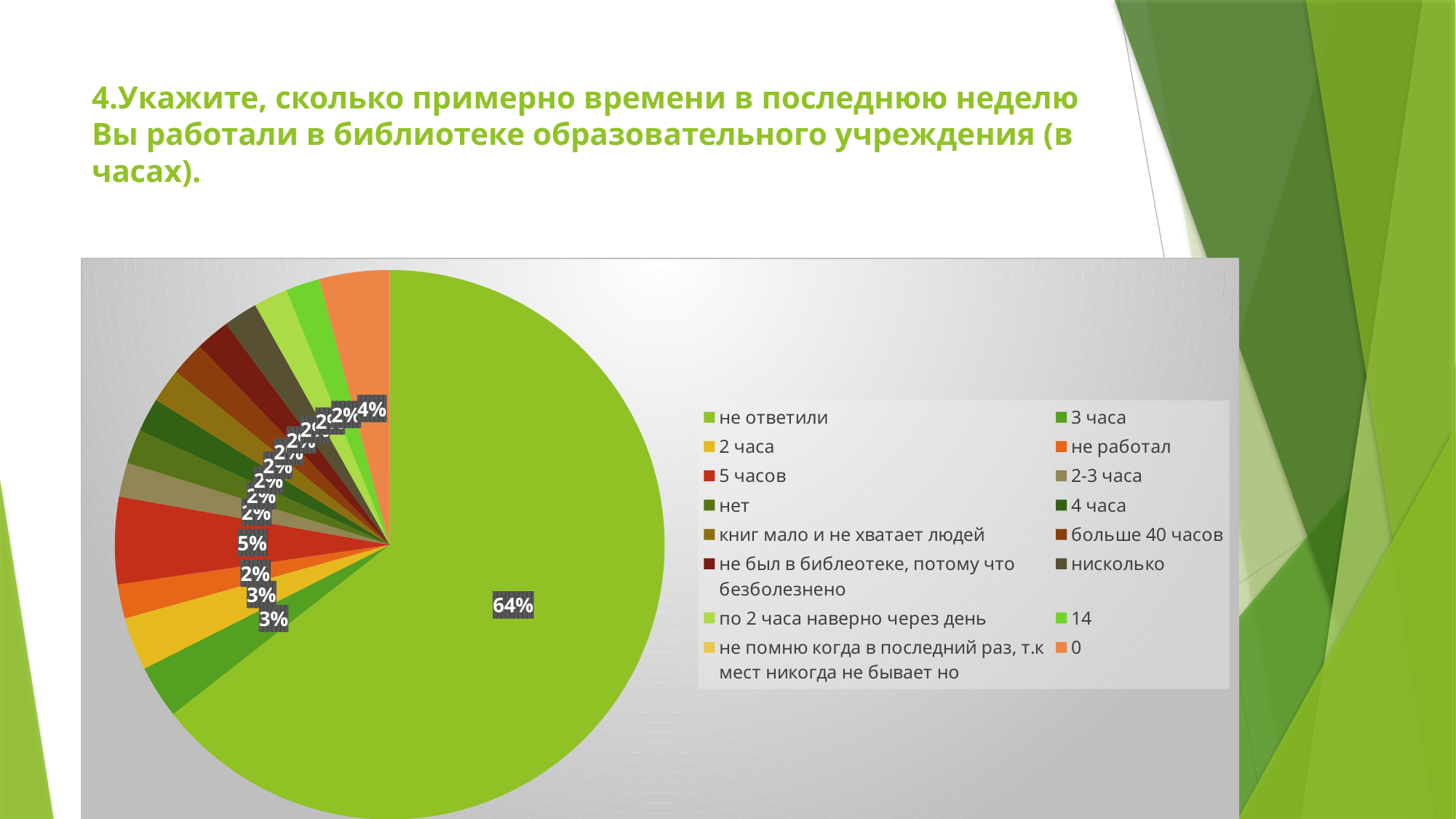
What is the value shown for "не работал"? 2% How many entries does the legend list? 16 What is the value shown for "3 часа"? 3% Which is larger, the slice for "5 часов" or the slice for "0"? 5 часов What is the value shown for "5 часов"? 5% What kind of chart is shown on the slide? pie chart Which is larger, the slice for "3 часа" or the slice for "не работал"? 3 часа What is the value shown for the category "0"? 4% What colour is the slice for "не ответили"? green Which category has the largest slice of the pie? не ответили What share of the pie does the slice for "не ответили" represent? 64% What is the difference between the values for "не ответили" and "5 часов"? 59%